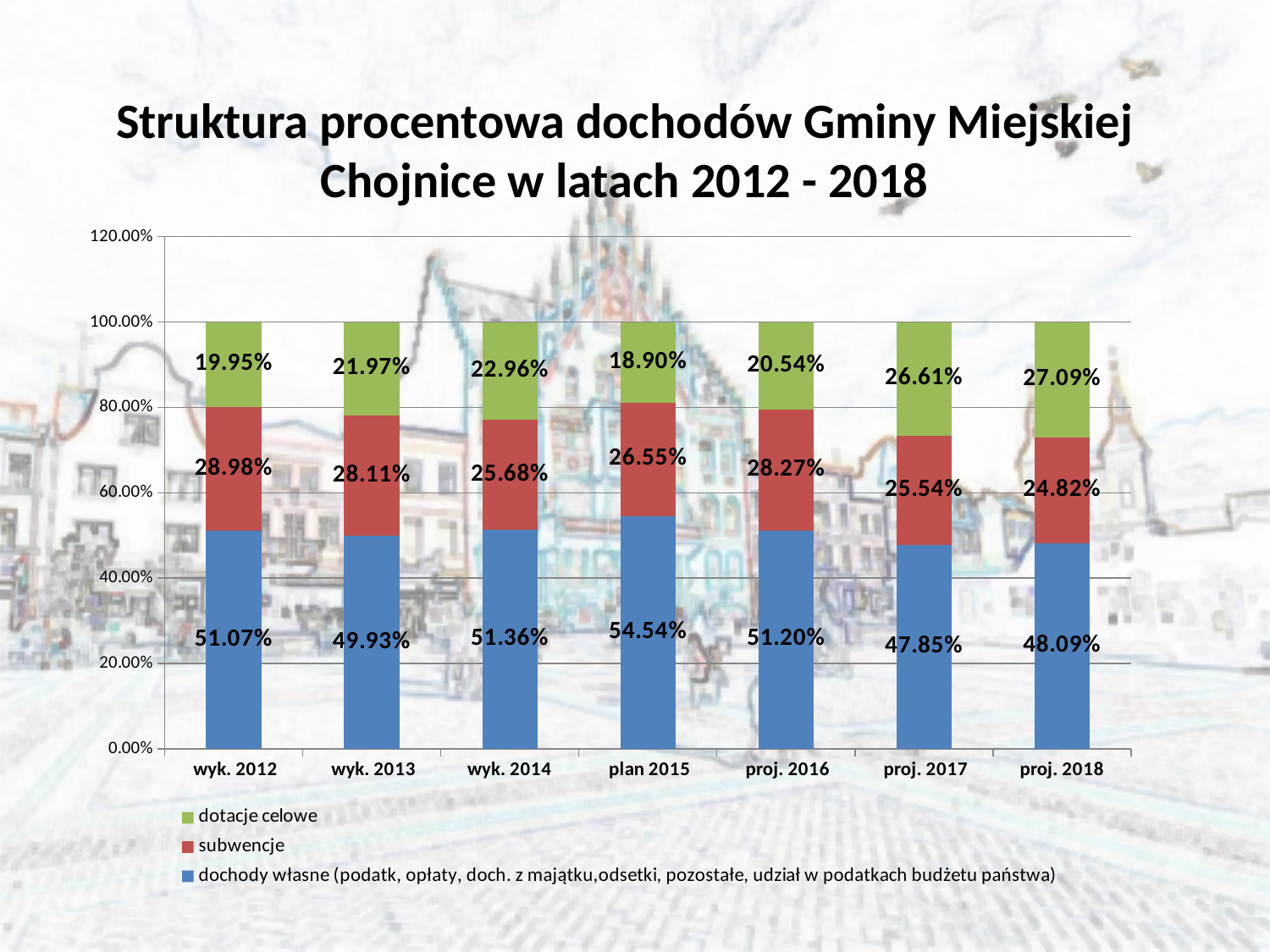
What is the difference between the dochody własne values for plan 2015 and proj. 2017? 6.69 percentage points How many categories are shown on the x axis? 7 How many series does the legend list? 3 What is the value of dotacje celowe for proj. 2018? 27.09% Which category has the highest value for dochody własne? plan 2015 Which category has the lowest value for subwencje? proj. 2018 What is the value of dochody własne for plan 2015? 54.54% What is the value of subwencje for wyk. 2014? 25.68% Do the dotacje celowe values rise or fall from proj. 2016 to proj. 2018? Rise Which is larger: subwencje for wyk. 2012 or subwencje for proj. 2017? wyk. 2012 Which category has the lowest value for dotacje celowe? plan 2015 What kind of chart is shown on the slide? Stacked bar chart